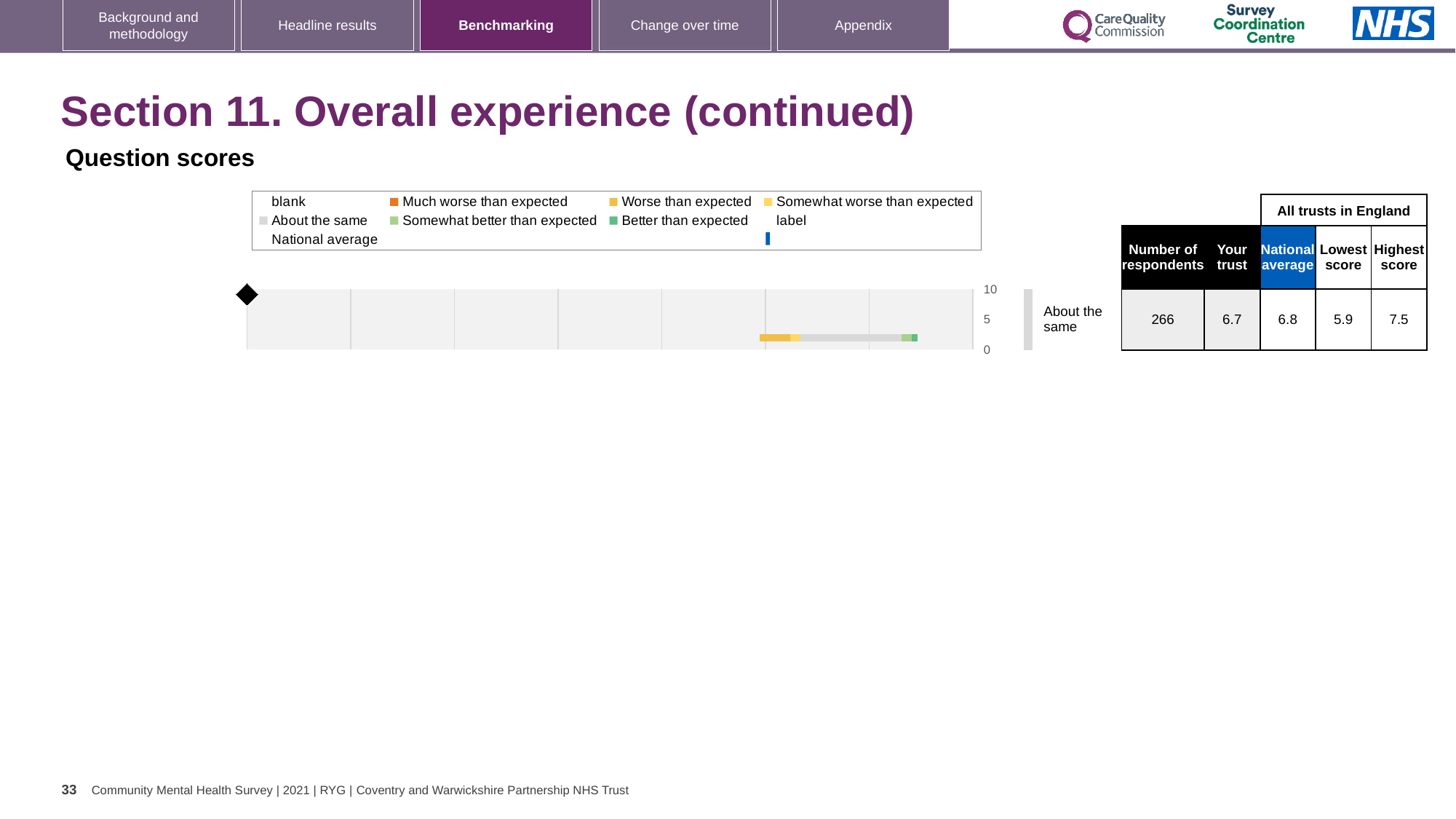
Is the trust's score for 'About the same' greater or less than 5 on the chart axis? greater What is the highest score among all trusts in England for the 'About the same' question? 7.5 What kind of chart is shown on the slide? bar chart What colour does the legend use for 'Much worse than expected'? orange What is the label of the single category plotted in the chart? About the same How many question categories are plotted in the chart? 1 What is the national average score for the 'About the same' question? 6.8 What is the lowest score among all trusts in England for the 'About the same' question? 5.9 How many respondents answered the 'About the same' question? 266 What is the difference between the highest score and the lowest score for the 'About the same' question? 1.6 Which is larger for the 'About the same' question: the trust's score or the national average? national average What is the 'Your trust' score for the 'About the same' question? 6.7